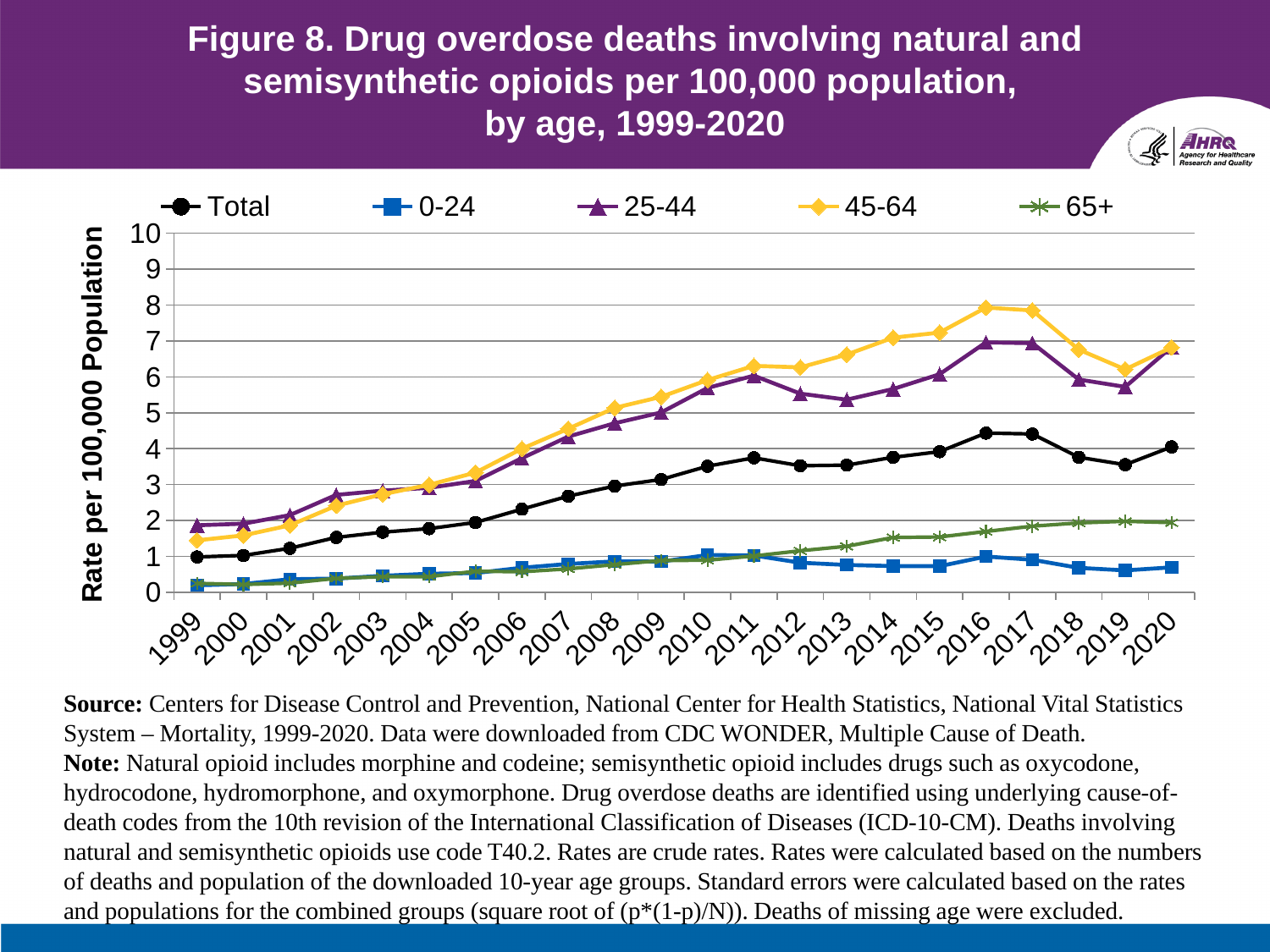
Is the value for the 0-24 group in 1999 greater or less than 1? less Which age group has the lowest rate in 2020? 0-24 Is the value for Total in 2020 greater or less than 5? less How many years are plotted along the x axis? 22 Is the value for the 25-44 group in 2011 greater or less than 5? greater What is the label of the y axis? Rate per 100,000 Population Does the Total rate rise or fall from 1999 to 2011? rise Which age group has the highest rate in 2016? 45-64 In 2018, which is larger: the rate for 65+ or the rate for 0-24? 65+ What kind of chart is shown on the slide? line chart How many series does the legend list? 5